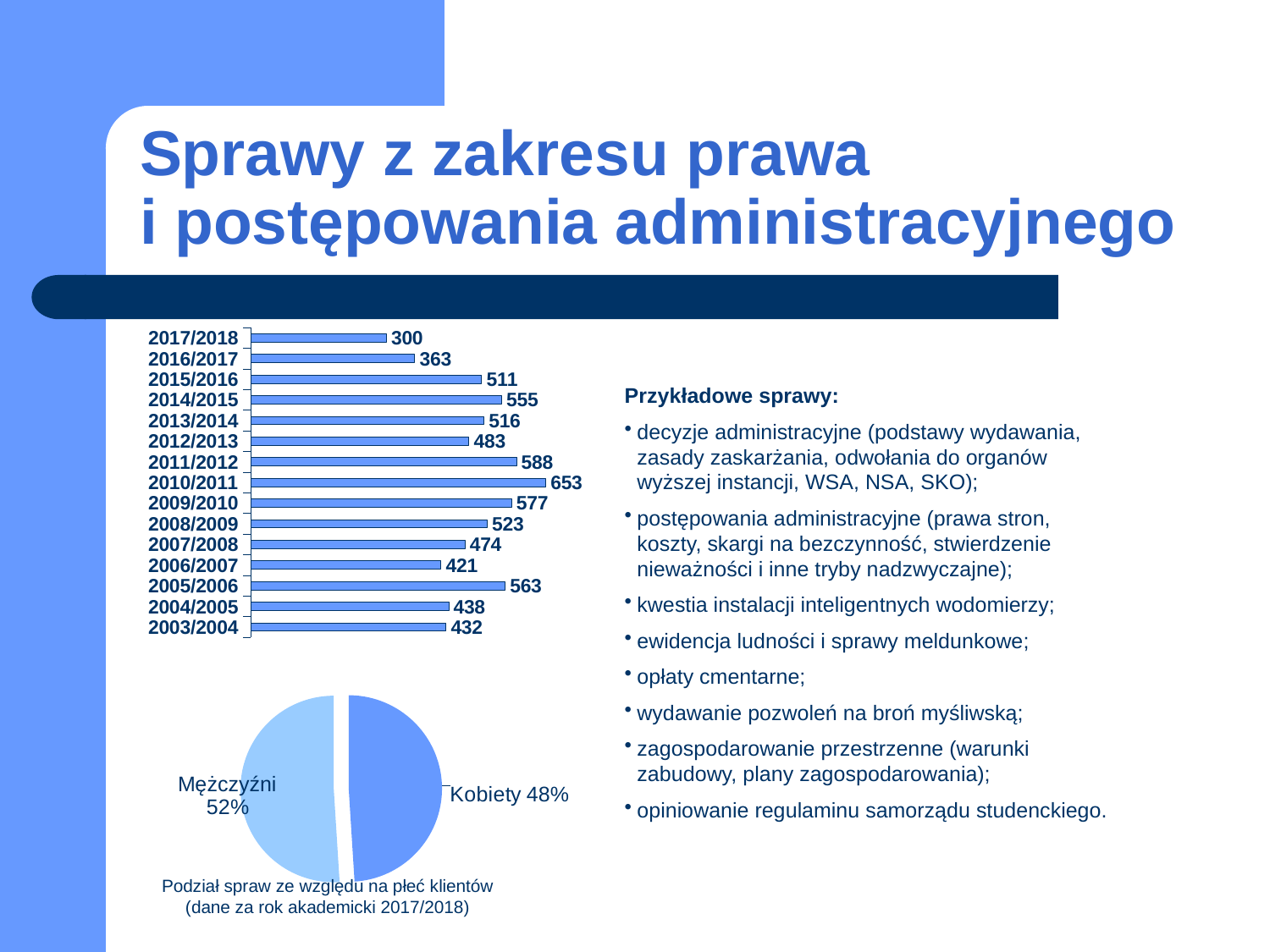
In the pie chart at the bottom left of the slide, what share is labelled Mężczyźni? 52% In the pie chart at the bottom left of the slide, what share is labelled Kobiety? 48% In the bar chart at the top left of the slide, which is larger, the value for 2014/2015 or the value for 2013/2014? 2014/2015 In the bar chart at the top left of the slide, what is the value for 2010/2011? 653 In the bar chart at the top left of the slide, which academic year has the lowest value? 2017/2018 In the bar chart at the top left of the slide, what is the value for 2005/2006? 563 What kind of chart is shown at the top left of the slide? Bar chart In the bar chart at the top left of the slide, what is the difference between the values for 2010/2011 and 2017/2018? 353 In the bar chart at the top left of the slide, which academic year has the highest value? 2010/2011 What is the caption below the pie chart at the bottom left of the slide? Podział spraw ze względu na płeć klientów (dane za rok akademicki 2017/2018) In the bar chart at the top left of the slide, how many academic years are shown? 15 In the bar chart at the top left of the slide, what is the value for 2017/2018? 300